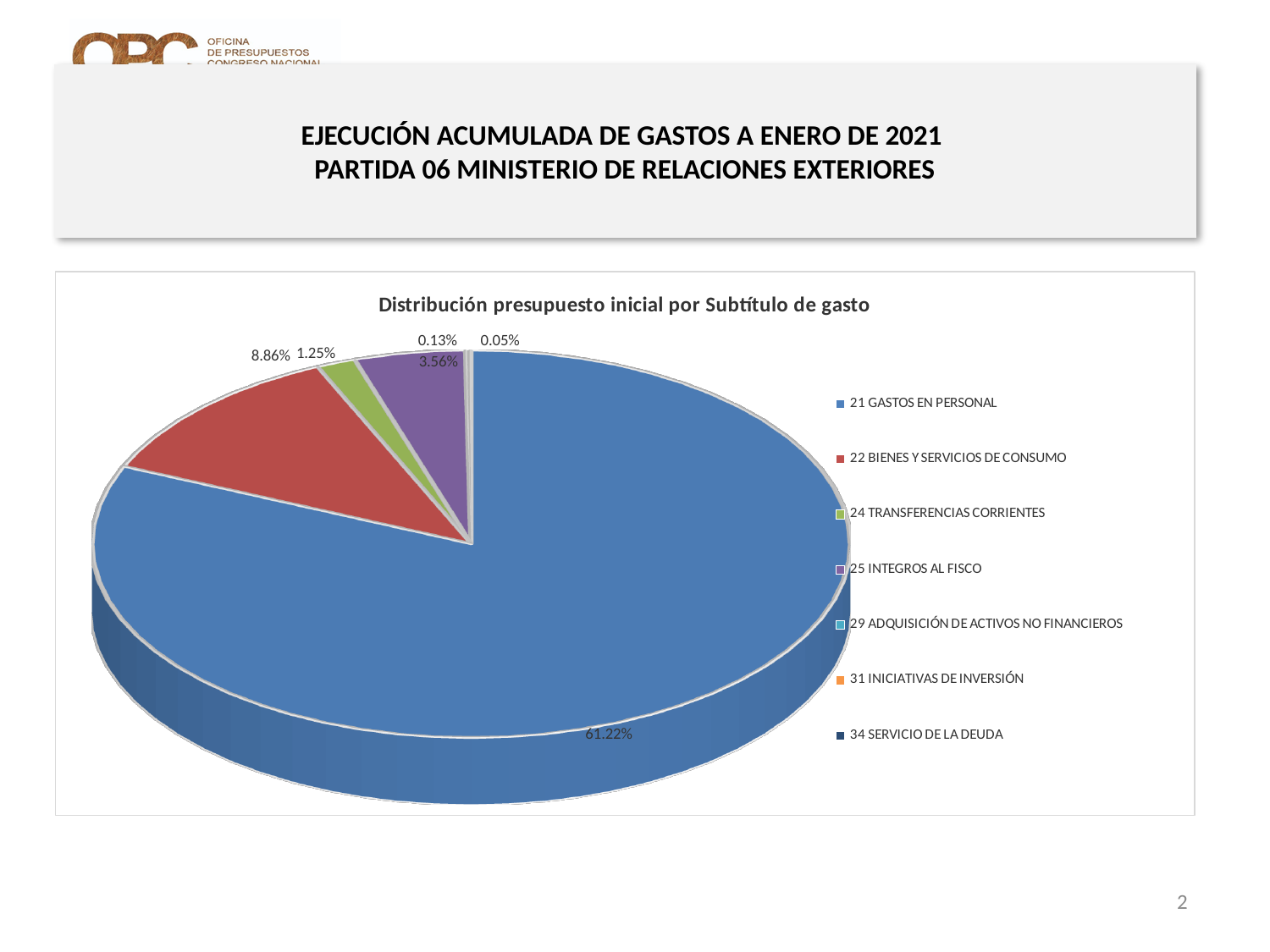
What colour is the slice for 22 BIENES Y SERVICIOS DE CONSUMO? Red What kind of chart is shown on the slide? Pie chart Which is larger, the slice for 24 TRANSFERENCIAS CORRIENTES or the slice for 25 INTEGROS AL FISCO? 25 INTEGROS AL FISCO How many categories does the chart legend list? 7 What share of the pie does 22 BIENES Y SERVICIOS DE CONSUMO have? 8.86% What is the title of the chart? Distribución presupuesto inicial por Subtítulo de gasto Which is larger, the slice for 22 BIENES Y SERVICIOS DE CONSUMO or the slice for 25 INTEGROS AL FISCO? 22 BIENES Y SERVICIOS DE CONSUMO What share of the pie does 25 INTEGROS AL FISCO have? 3.56% Which category has the largest slice of the pie? 21 GASTOS EN PERSONAL What is the difference in percentage points between the slices for 22 BIENES Y SERVICIOS DE CONSUMO and 25 INTEGROS AL FISCO? 5.30% What share of the pie does 24 TRANSFERENCIAS CORRIENTES have? 1.25% What is the difference in percentage points between the slices for 25 INTEGROS AL FISCO and 24 TRANSFERENCIAS CORRIENTES? 2.31%